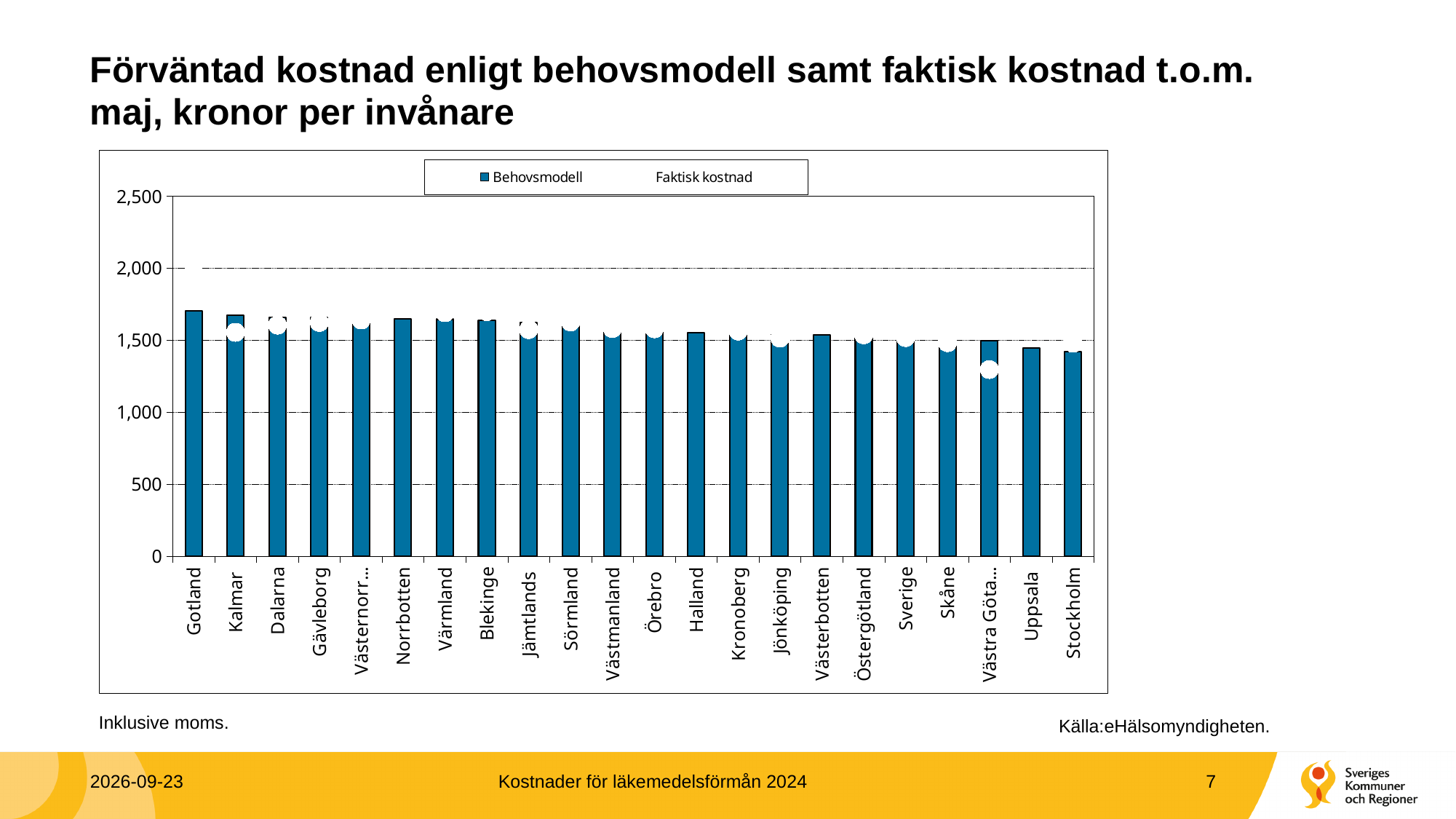
Which has the larger Behovsmodell value, Gotland or Stockholm? Gotland How many series does the legend list? 2 How many categories are shown on the x axis? 22 What are the two series named in the legend? Behovsmodell and Faktisk kostnad Is the Behovsmodell value for Gotland greater or less than 2,000? less Do the Behovsmodell values generally rise or fall from left to right along the x axis? fall Which category has the highest Behovsmodell bar? Gotland What is the first category on the x axis? Gotland Is the Behovsmodell value for Stockholm greater or less than 1,500? less What kind of chart is shown on the slide? bar chart Is the Behovsmodell value for Gotland greater or less than 1,500? greater